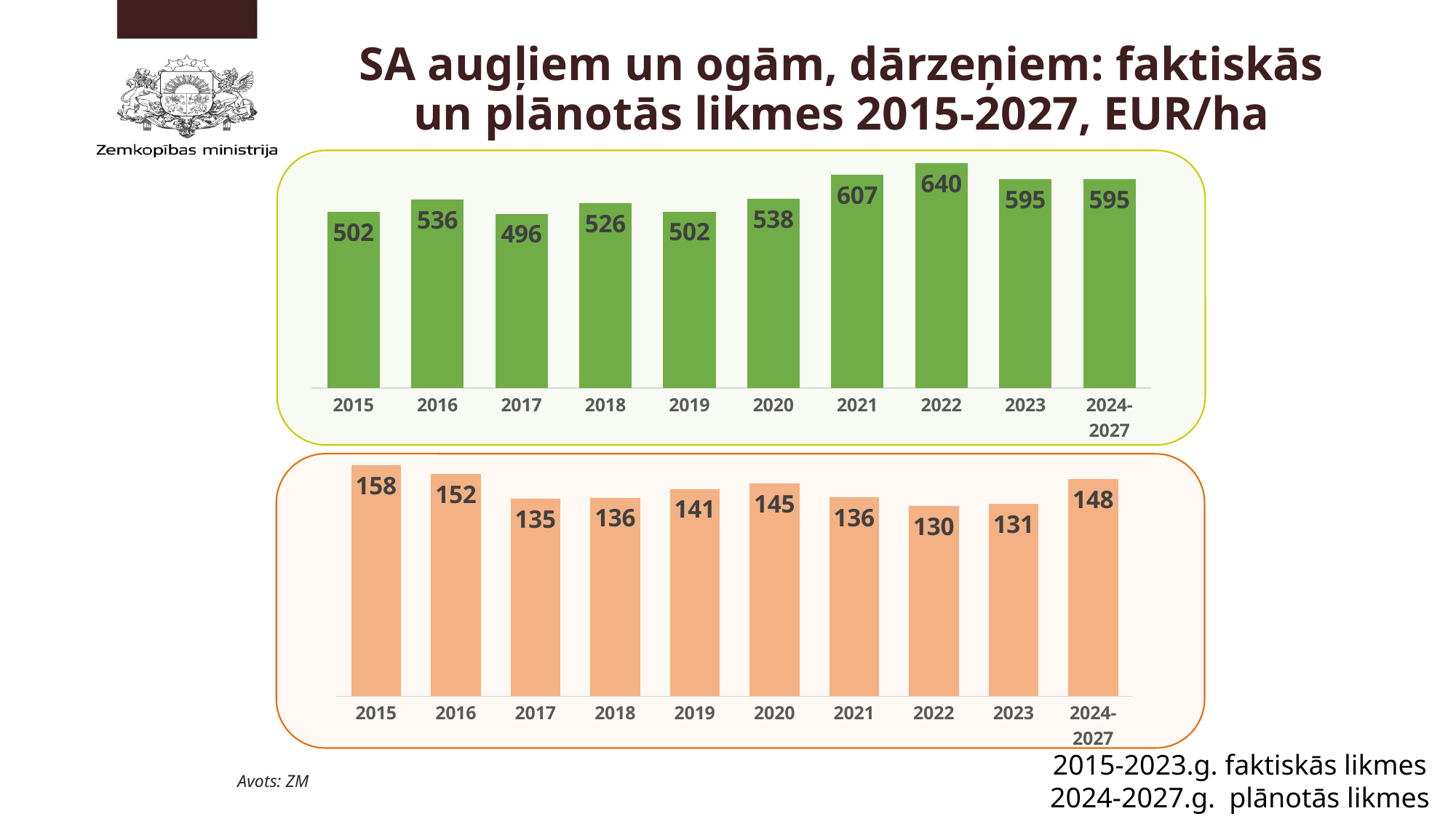
In the bottom (orange) chart, what is the difference between the values for 2015 and 2024-2027? 10 In the top (green) chart, what is the value for 2024-2027? 595 In the top (green) chart, which year has the highest value? 2022 In the top (green) chart, what is the difference between the values for 2022 and 2021? 33 In the bottom (orange) chart, which is larger, the value for 2019 or the value for 2021? 2019 In the top (green) chart, which year has the lowest value? 2017 What kind of chart is the bottom (orange) chart? Bar chart In the bottom (orange) chart, which year has the lowest value? 2022 How many categories are shown on the x axis of the top (green) chart? 10 In the bottom (orange) chart, which year has the highest value? 2015 In the top (green) chart, what is the value for 2022? 640 In the bottom (orange) chart, what is the value for 2015? 158